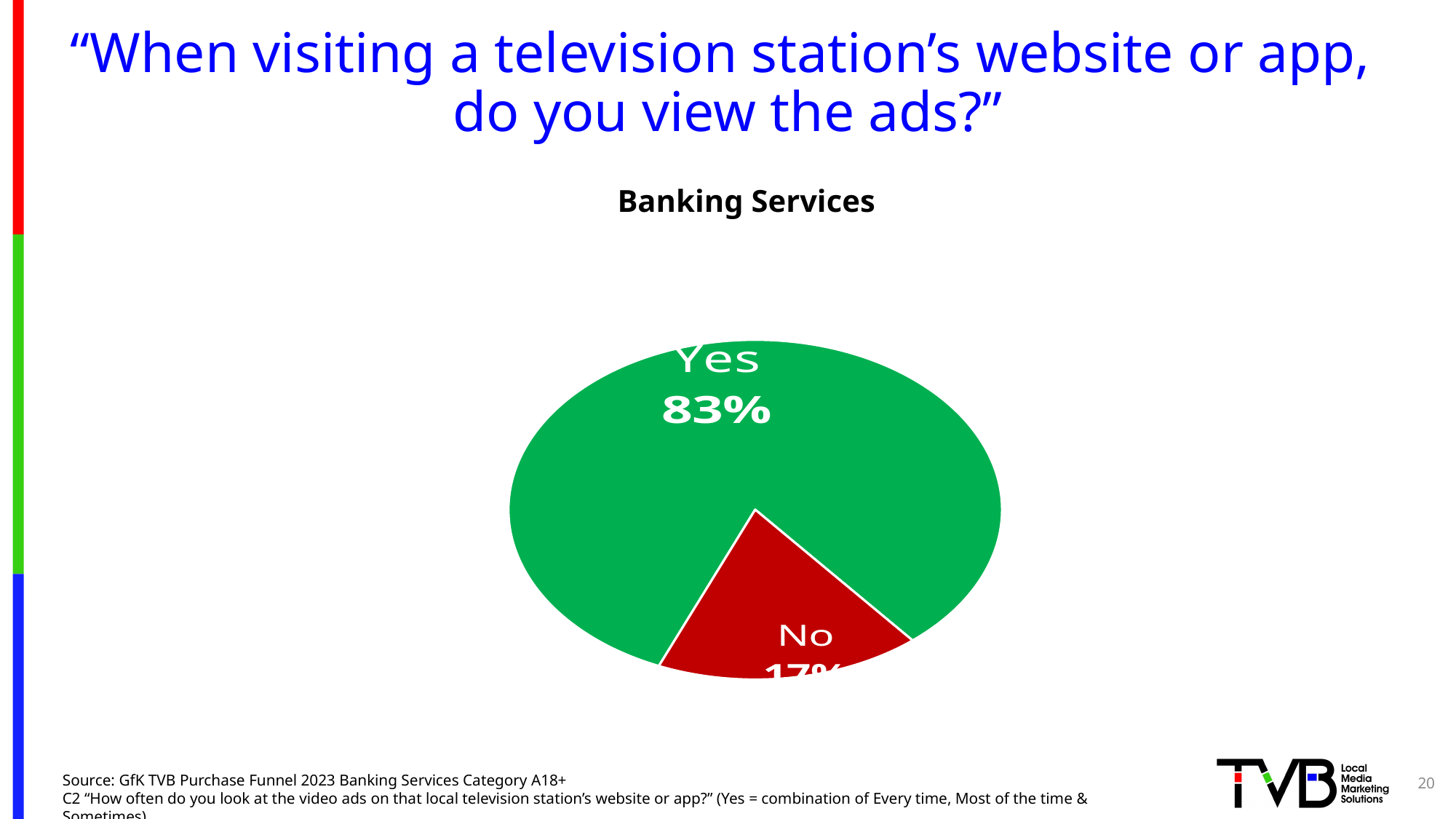
What is the difference in percentage points between the "Yes" and "No" slices? 66 Which slice of the pie chart is the largest? Yes What colour is the "Yes" slice of the pie chart? green Which slice of the pie chart is the smallest? No What is the title of the pie chart? Banking Services What percentage of respondents answered "Yes" in the Banking Services pie chart? 83% What share of the pie does the "No" slice represent? 17% Which is larger, the "Yes" slice or the "No" slice? Yes What kind of chart is shown on the slide? pie chart How many slices does the pie chart have? 2 What percentage of respondents answered "No" in the Banking Services pie chart? 17%